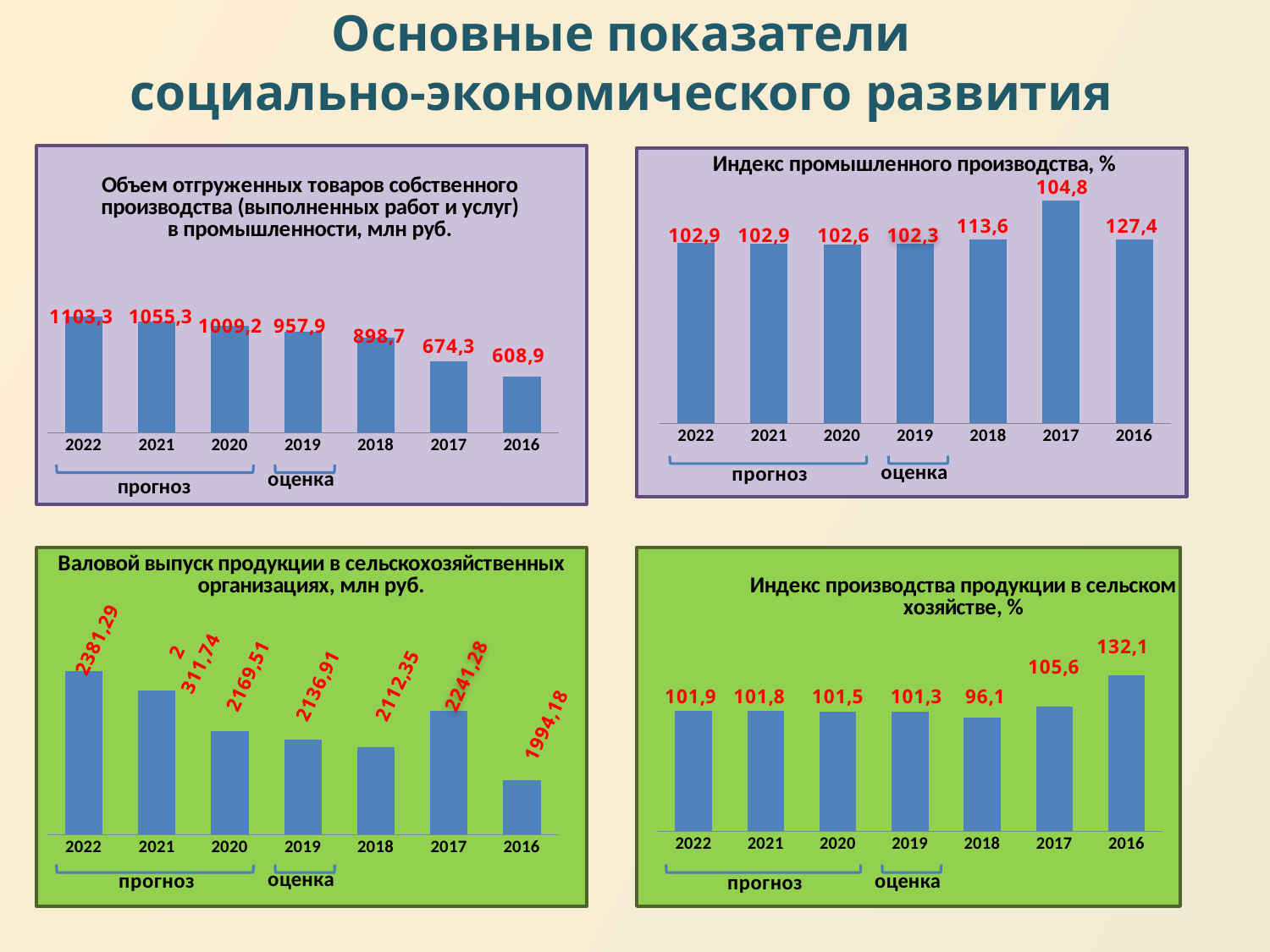
In the chart 'Валовой выпуск продукции в сельскохозяйственных организациях, млн руб.', what is the value for 2017? 2241,28 In the chart 'Индекс производства продукции в сельском хозяйстве, %', what is the value for 2018? 96,1 How many years are shown on the x axis of the chart 'Индекс производства продукции в сельском хозяйстве, %'? 7 In the chart 'Индекс производства продукции в сельском хозяйстве, %', which year has the highest value? 2016 What kind of chart is 'Индекс промышленного производства, %'? bar chart In the chart 'Объем отгруженных товаров собственного производства (выполненных работ и услуг) в промышленности, млн руб.', which year has the lowest value? 2016 In the chart 'Валовой выпуск продукции в сельскохозяйственных организациях, млн руб.', which year has the highest value? 2022 In the chart 'Объем отгруженных товаров собственного производства (выполненных работ и услуг) в промышленности, млн руб.', what is the difference between the values for 2022 and 2016? 494,4 In the chart 'Валовой выпуск продукции в сельскохозяйственных организациях, млн руб.', which is larger, the value for 2018 or the value for 2017? 2017 In the chart 'Индекс промышленного производства, %', what is the value for 2019? 102,3 In the chart 'Объем отгруженных товаров собственного производства (выполненных работ и услуг) в промышленности, млн руб.', what is the value for 2022? 1103,3 In the chart 'Индекс промышленного производства, %', what is the value for 2018? 113,6